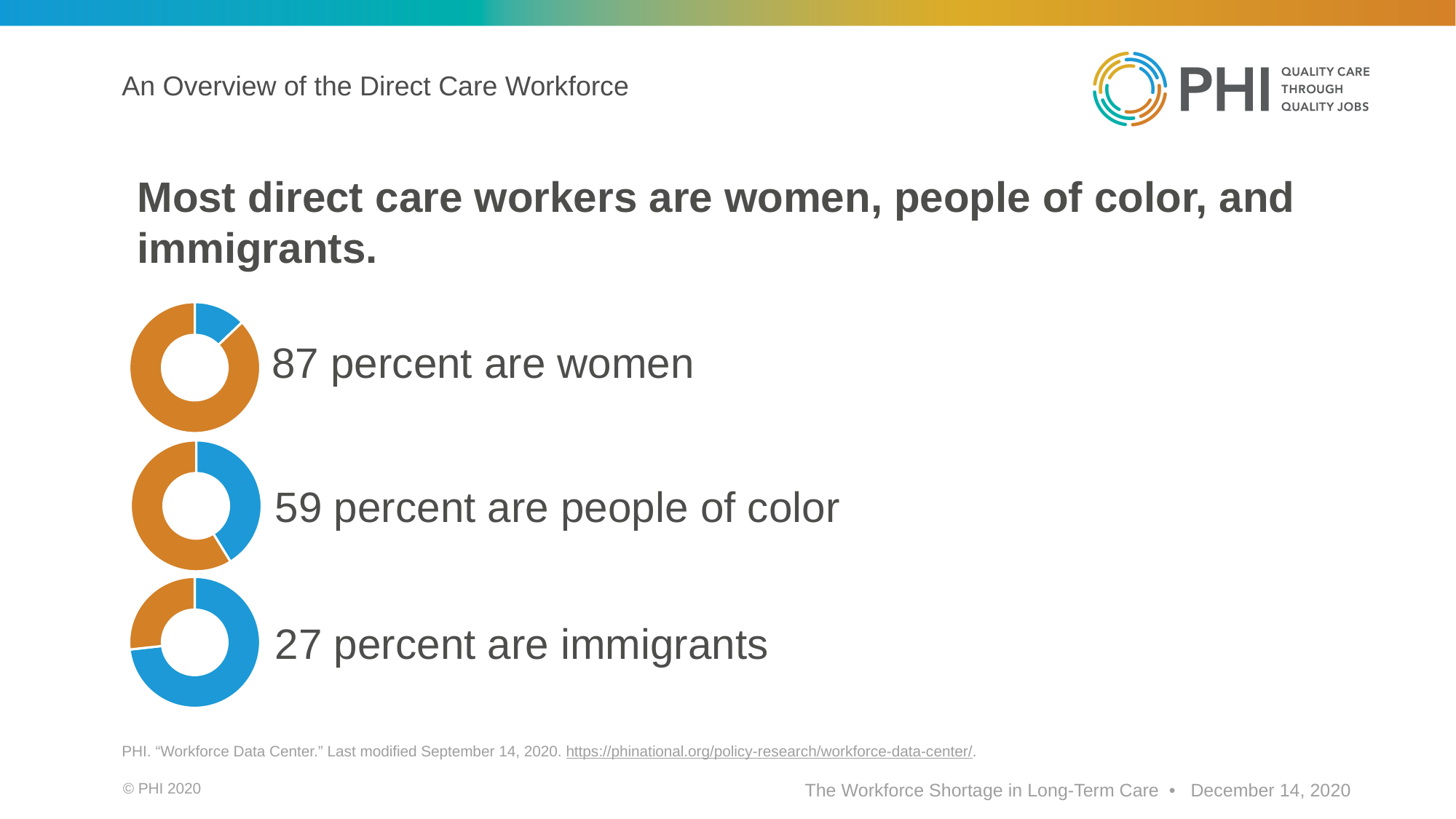
What is the difference in percentage points between the share of direct care workers who are people of color and the share who are immigrants? 32 Which of the three groups shown (women, people of color, immigrants) has the lowest percentage? Immigrants In the top donut chart, what share of the ring is not covered by the orange segment representing women? 13 percent What percentage of direct care workers are women, according to the top donut chart? 87 percent What is the difference in percentage points between the share of direct care workers who are women and the share who are people of color? 28 Which is larger: the percentage of direct care workers who are people of color or the percentage who are immigrants? People of color Which of the three groups shown (women, people of color, immigrants) has the highest percentage? Women What percentage of direct care workers are immigrants, according to the bottom donut chart? 27 percent What colour is the segment representing the stated percentage in each donut chart? Orange How many donut charts are shown on the slide? 3 What kind of chart is used to show each percentage on the slide? Donut chart What percentage of direct care workers are people of color, according to the middle donut chart? 59 percent